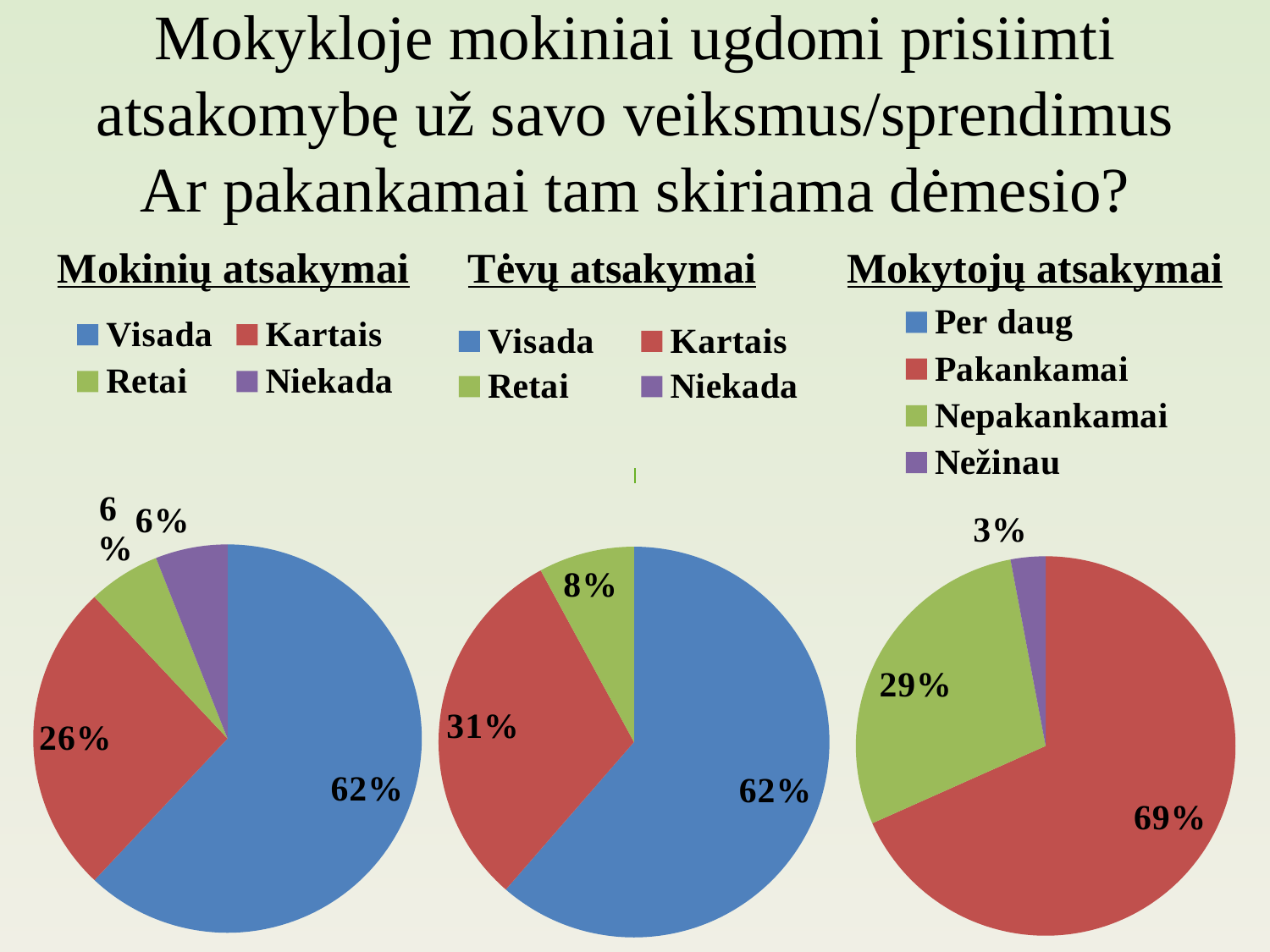
In the 'Mokinių atsakymai' pie chart, which category has the largest slice? Visada In the 'Mokinių atsakymai' pie chart, what percentage is shown for Visada? 62% In the 'Tėvų atsakymai' pie chart, what percentage is shown for Kartais? 31% What type of chart is used for 'Tėvų atsakymai'? Pie chart How many entries does the legend of the 'Mokytojų atsakymai' chart list? 4 In the 'Tėvų atsakymai' pie chart, which is larger, Kartais or Retai? Kartais In the 'Mokytojų atsakymai' pie chart, what is the difference between Pakankamai and Nepakankamai? 40 percentage points In the 'Mokytojų atsakymai' pie chart, what percentage is shown for Pakankamai? 69% In the 'Mokinių atsakymai' pie chart, what percentage is shown for Kartais? 26% In the 'Mokytojų atsakymai' pie chart, what percentage is shown for Nepakankamai? 29% In the 'Mokytojų atsakymai' pie chart, what percentage is shown for Nežinau? 3% In the 'Tėvų atsakymai' pie chart, what percentage is shown for Retai? 8%